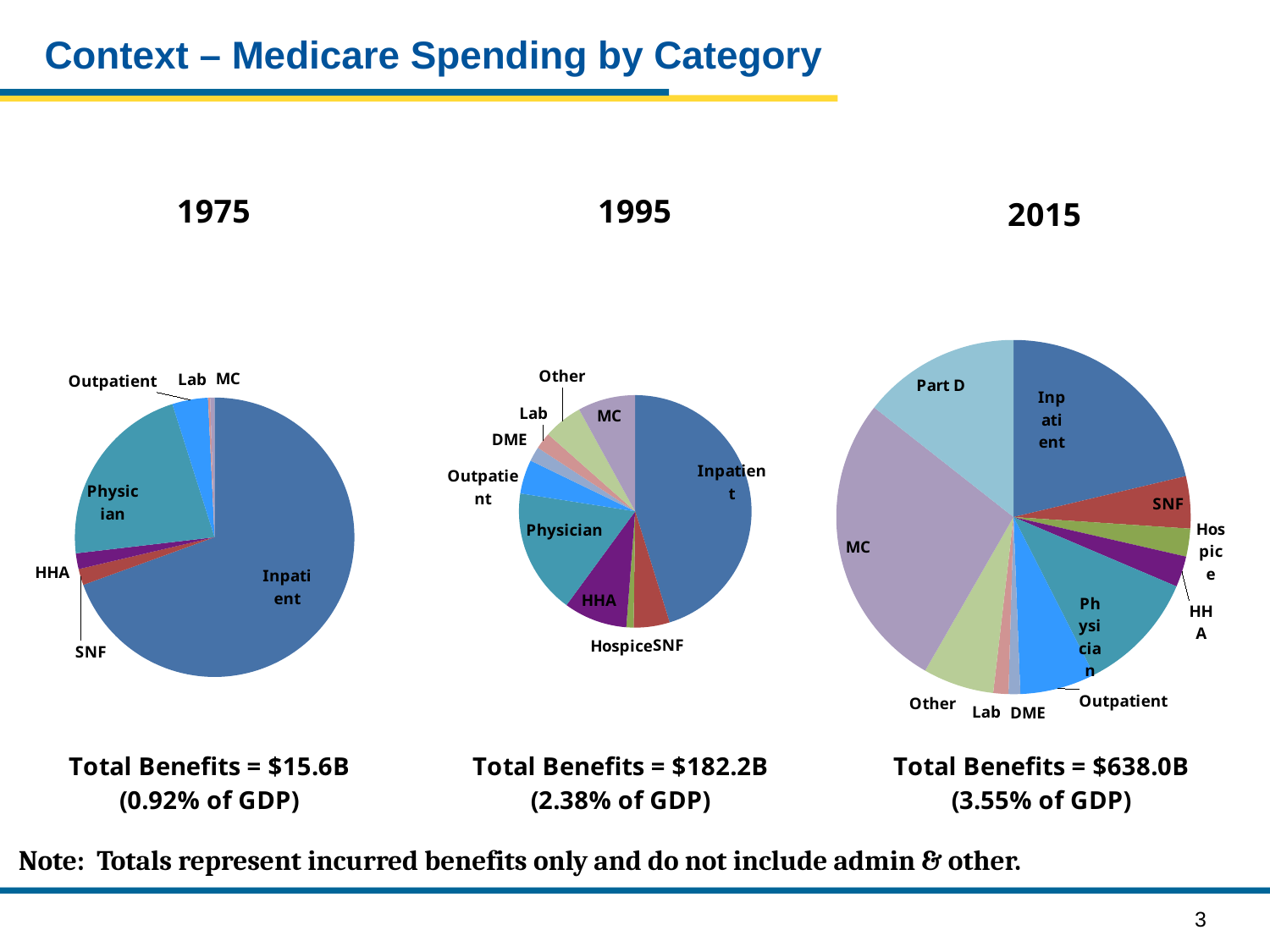
In the 2015 pie chart, which category has the largest slice? MC In the 1975 pie chart, which category has the largest slice? Inpatient How many categories are shown in the 2015 pie chart? 11 In the 1995 pie chart, which category has the largest slice? Inpatient How many categories are shown in the 1975 pie chart? 7 Do the total benefits rise or fall from the 1975 chart to the 2015 chart? rise In the 2015 pie chart, which slice is larger, Part D or SNF? Part D What percentage of GDP is shown for the 2015 chart? 3.55% of GDP What kind of chart is used for the 1975 Medicare spending breakdown? pie chart How many pie charts are shown on the slide? 3 In the 1975 pie chart, which slice is larger, Physician or Outpatient? Physician What are the total benefits shown for the 1995 chart? $182.2B